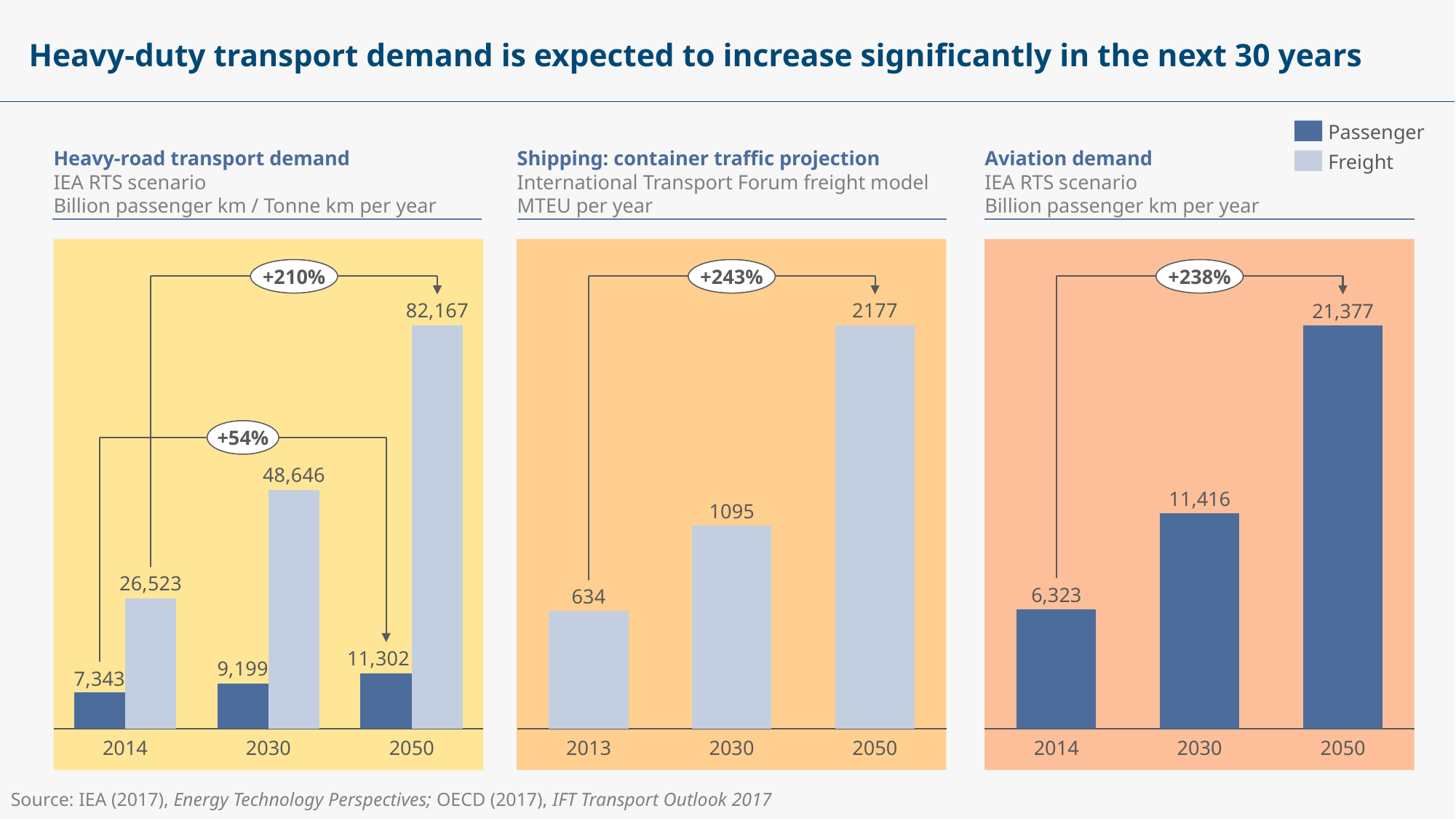
In the 'Heavy-road transport demand' chart, what is the Freight value for 2050? 82,167 In the 'Heavy-road transport demand' chart, what is the difference between the Passenger values for 2050 and 2014? 3,959 In the 'Aviation demand' chart, what is the value for 2050? 21,377 In the 'Heavy-road transport demand' chart, which is larger in 2030: the Passenger value or the Freight value? Freight In the 'Shipping: container traffic projection' chart, which year has the lowest value? 2013 What kind of chart is the 'Shipping: container traffic projection' chart? Bar chart In the 'Shipping: container traffic projection' chart, what is the difference between the 2050 and 2013 values? 1543 In the 'Aviation demand' chart, which year has the highest value? 2050 How many years are shown on the x axis of the 'Aviation demand' chart? 3 In the 'Aviation demand' chart, do the values rise or fall from 2014 to 2050? Rise In the 'Shipping: container traffic projection' chart, what is the value for 2030? 1095 In the 'Heavy-road transport demand' chart, what is the Passenger value for 2014? 7,343